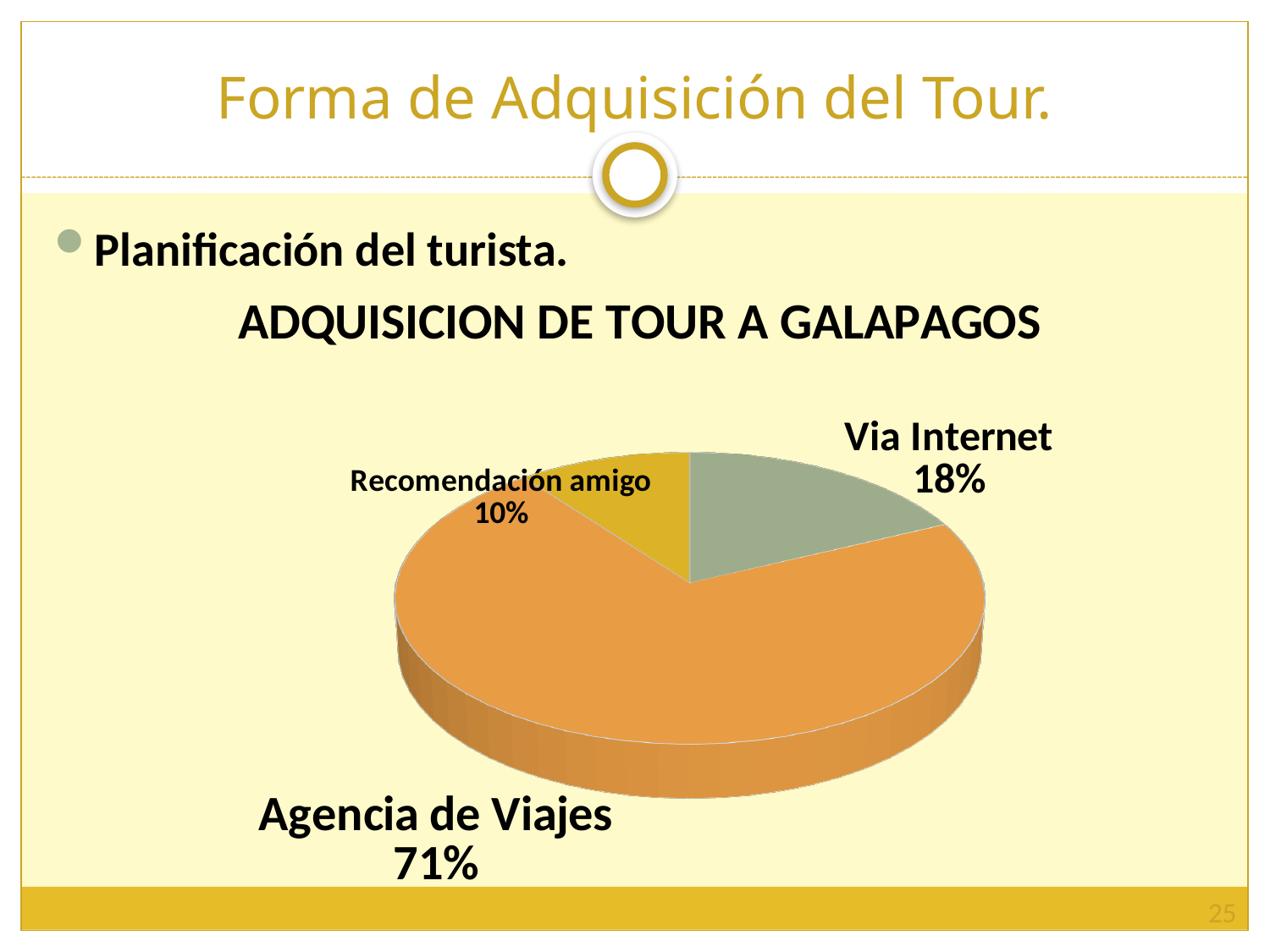
What is the difference in percentage points between Agencia de Viajes and Via Internet? 53 Which category has the largest share of the pie? Agencia de Viajes What percentage of the pie corresponds to Recomendación amigo? 10% What percentage of the pie corresponds to Agencia de Viajes? 71% What is the difference in percentage points between Via Internet and Recomendación amigo? 8 Which is larger, the share for Via Internet or the share for Recomendación amigo? Via Internet What percentage of the pie corresponds to Via Internet? 18% How many slices does the pie chart have? 3 What colour is the Agencia de Viajes slice? Orange What type of chart is shown on the slide? Pie chart What is the title of the chart? ADQUISICION DE TOUR A GALAPAGOS Which category has the smallest share of the pie? Recomendación amigo